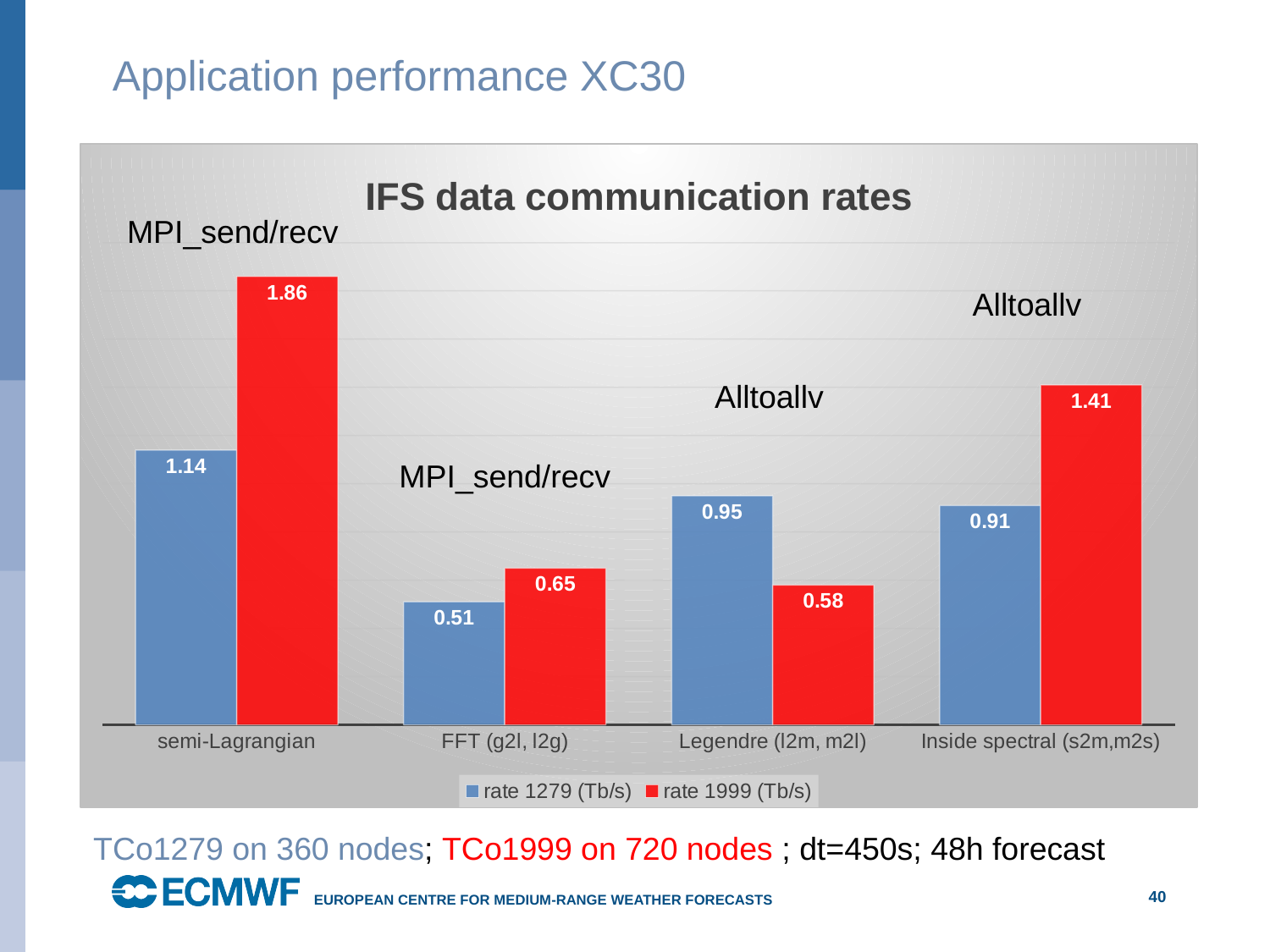
What is the rate 1279 (Tb/s) value for FFT (g2l, l2g)? 0.51 What is the rate 1999 (Tb/s) value for Inside spectral (s2m,m2s)? 1.41 What is the title of the chart? IFS data communication rates What is the rate 1999 (Tb/s) value for semi-Lagrangian? 1.86 What kind of chart is shown? bar chart Which category has the lowest rate 1279 (Tb/s) value? FFT (g2l, l2g) How many series does the legend list? 2 What is the rate 1279 (Tb/s) value for Legendre (l2m, m2l)? 0.95 For Legendre (l2m, m2l), which is larger: rate 1279 (Tb/s) or rate 1999 (Tb/s)? rate 1279 (Tb/s) How many categories are shown on the x axis? 4 Which category has the highest rate 1999 (Tb/s) value? semi-Lagrangian What is the difference between the rate 1999 and rate 1279 values for semi-Lagrangian? 0.72